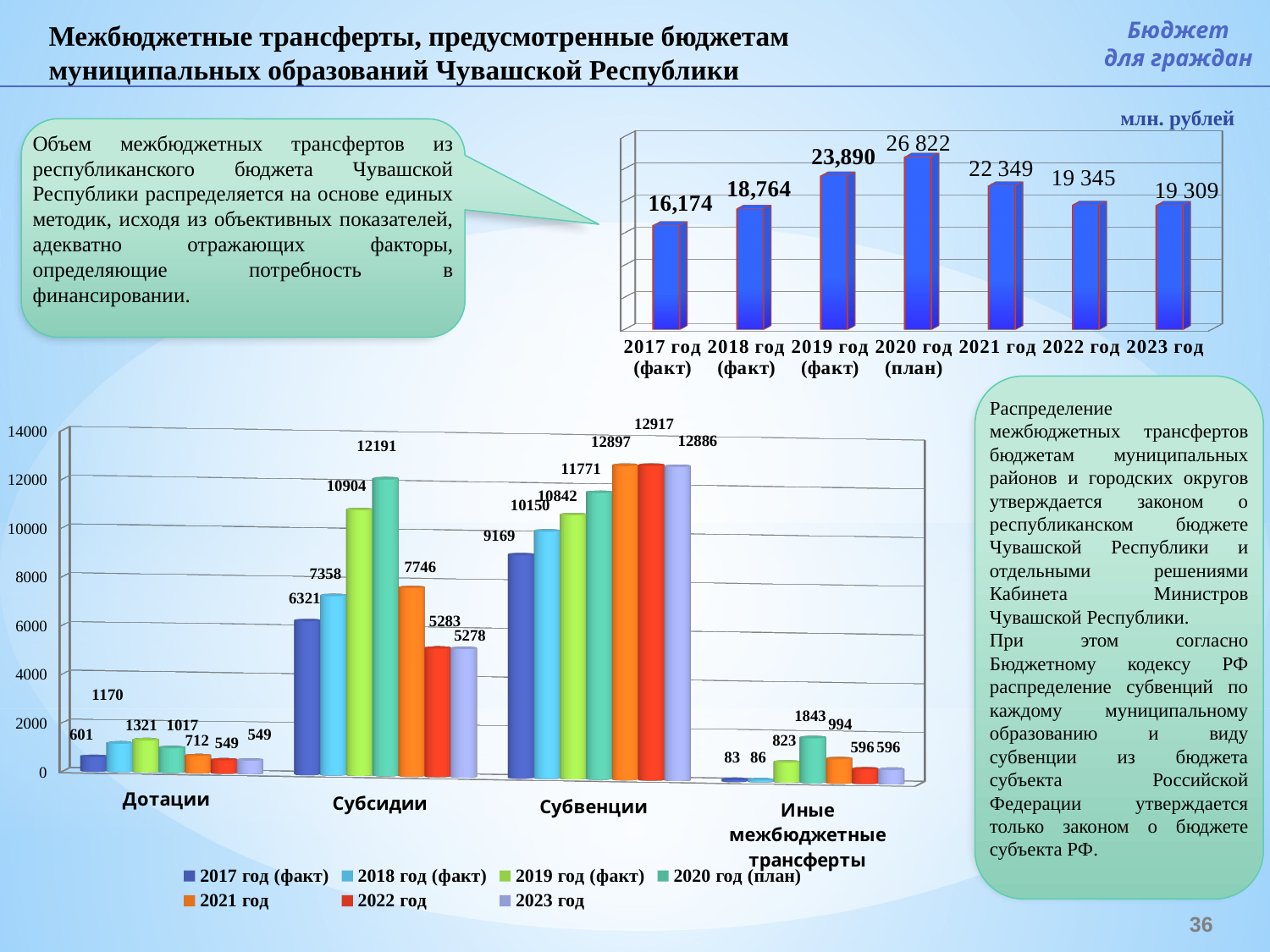
In the top-right chart, which year has the highest value? 2020 год (план) In the bottom chart, what is the value for Субсидии in 2020 год (план)? 12191 In the top-right chart, how many years are shown on the x axis? 7 In the top-right chart, which year has the lowest value? 2017 год (факт) In the bottom chart, how many series does the legend list? 7 In the top-right chart, what is the value for 2021 год? 22 349 In the top-right chart, what is the value for 2019 год (факт)? 23,890 In the bottom chart, what is the difference between Субсидии in 2020 год (план) and Субсидии in 2023 год? 6913 In the bottom chart, what is the value for Субвенции in 2017 год (факт)? 9169 What kind of chart is the bottom chart? bar chart In the bottom chart, which is larger: Дотации in 2018 год (факт) or Дотации in 2019 год (факт)? 2019 год (факт) In the top-right chart, what unit is stated above the chart? млн. рублей